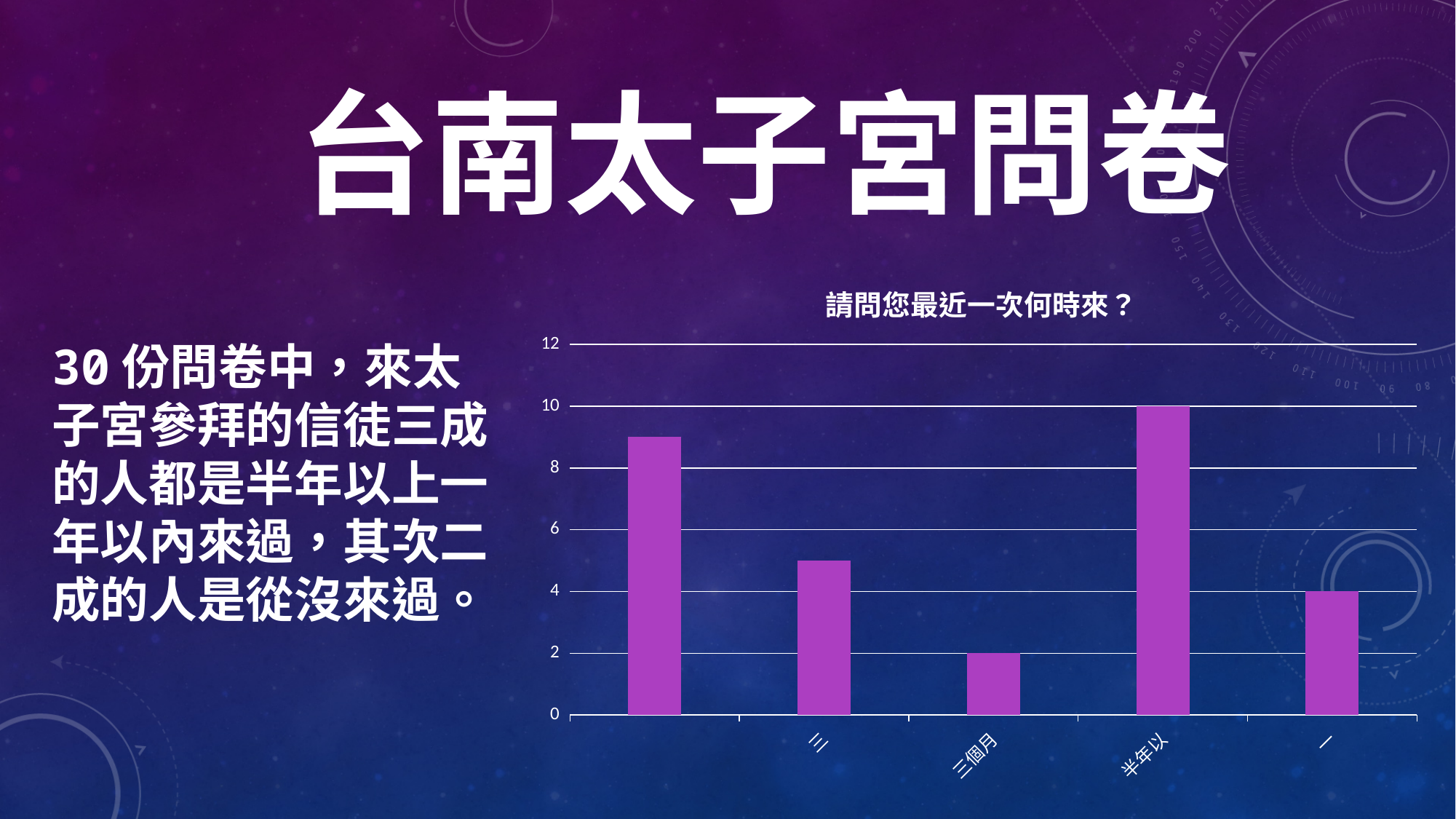
What is the title of the chart? 請問您最近一次何時來？ Is the value of the leftmost bar greater or less than 8? greater Which bar has the lowest value? 三個月 Is the value of the second bar from the left greater or less than 6? less What kind of chart is shown on the slide? bar chart What is the difference between the fourth bar (半年以...) and the bar labelled 三個月? 8 Which is larger, the leftmost bar or the rightmost bar? the leftmost bar What is the value of the bar labelled 三個月? 2 What is the value of the fourth bar from the left (labelled 半年以...)? 10 What is the value of the rightmost bar? 4 How many bars are plotted in the chart? 5 Which bar has the highest value? the fourth bar (半年以...)